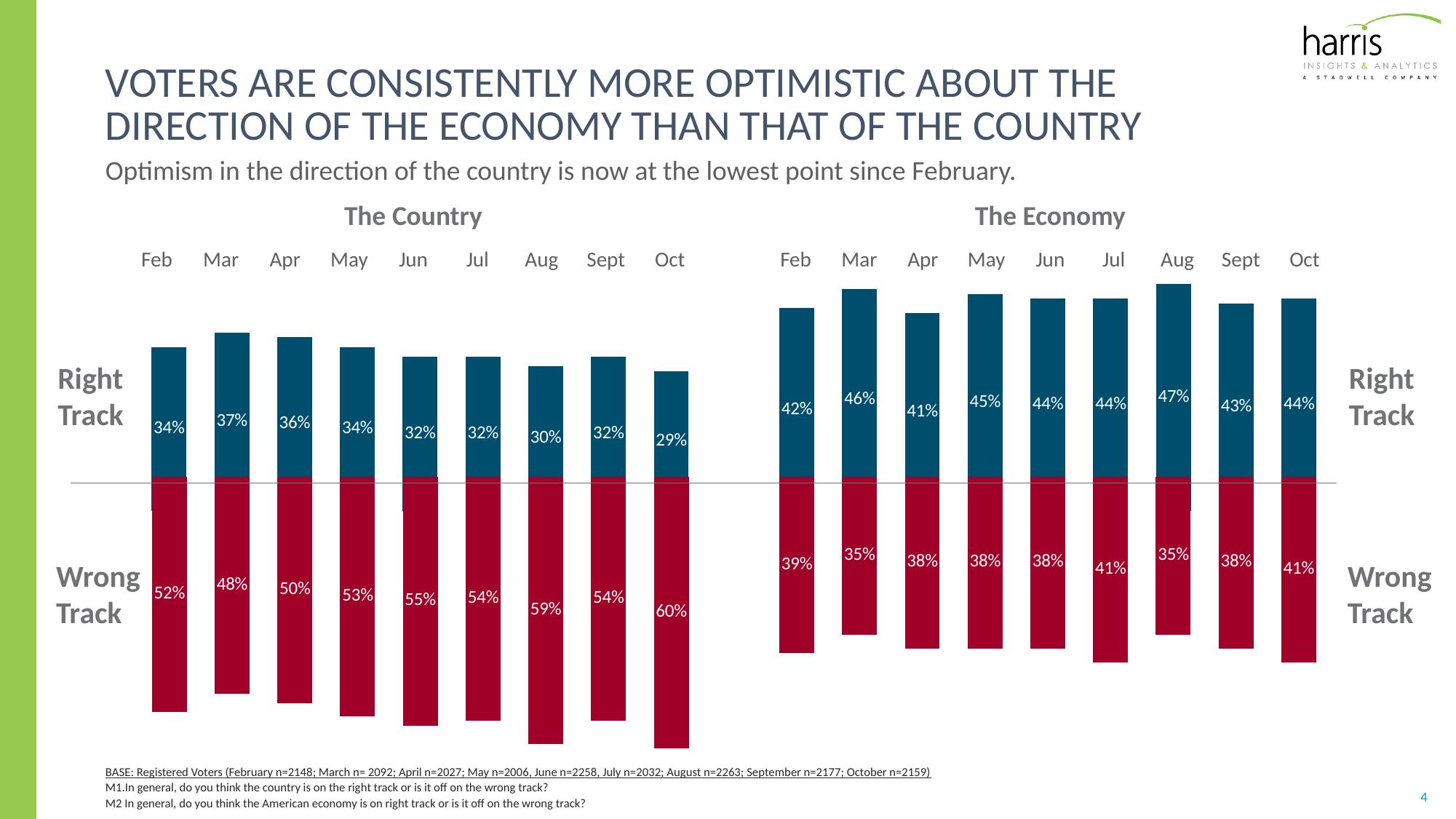
In The Economy chart, which month has the highest Right Track value? Aug In The Economy chart, what is the Wrong Track value for February? 39% In The Country chart, which is larger: the Wrong Track value for August or for September? August In The Country chart, which month has the highest Wrong Track value? Oct In The Economy chart, what is the total of Right Track and Wrong Track for October? 85% What kind of chart is The Country chart? Bar chart What colour are the Wrong Track bars in both charts? Red In The Country chart, which month has the lowest Right Track value? Oct In The Country chart, does the Right Track value rise or fall from September to October? Fall How many months are shown on the x axis of The Economy chart? 9 In The Economy chart, what is the difference between the Right Track values for March and April? 5% In The Country chart, what is the Right Track value for October? 29%